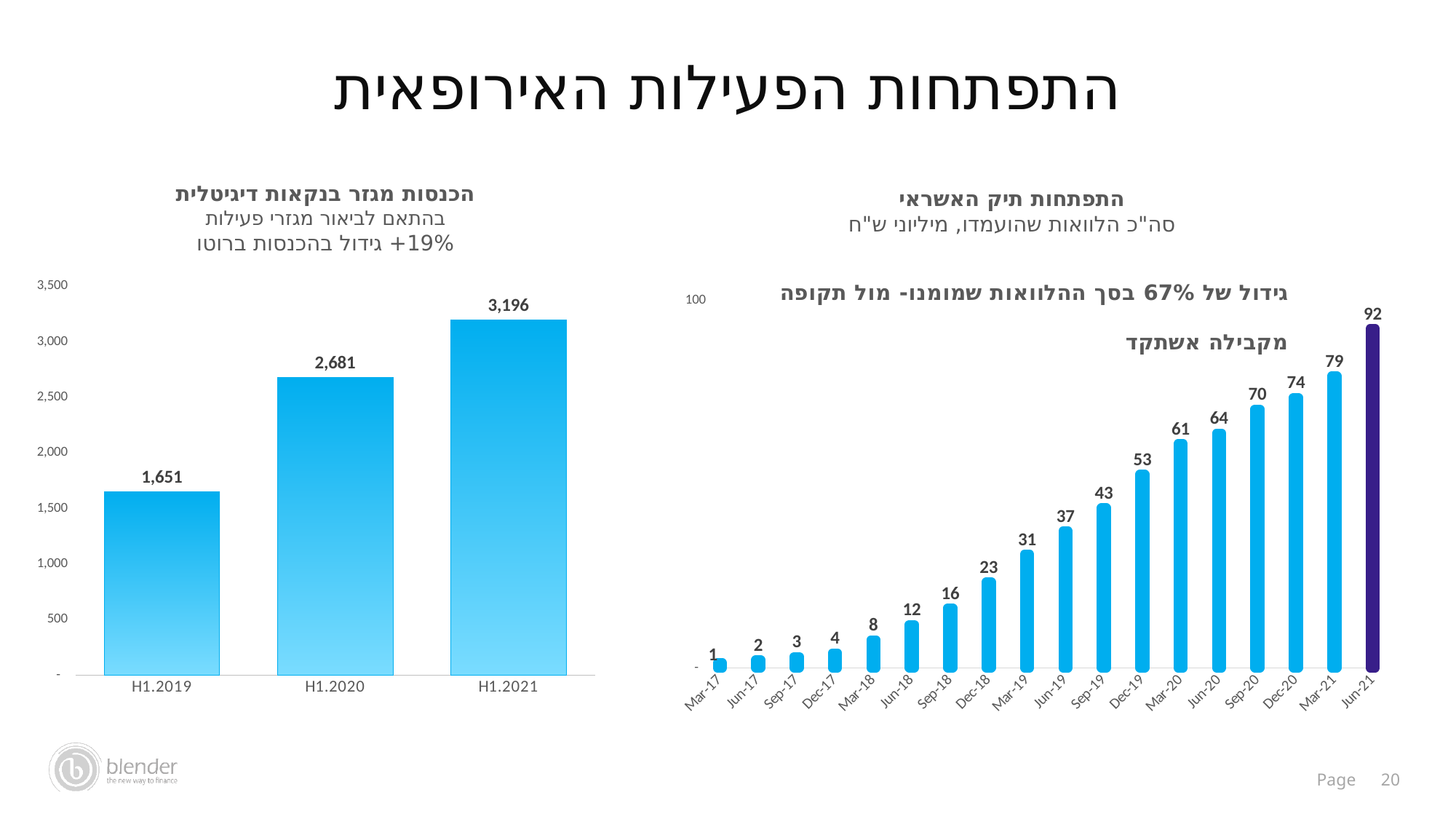
In the left chart, what is the value for H1.2019? 1,651 In the right chart, what is the difference between the Jun-21 and Mar-21 values? 13 In the right chart, what is the value for Jun-21? 92 What type of chart is the right chart? bar chart In the right chart, what is the value for Dec-19? 53 In the left chart, what is the difference between the H1.2020 and H1.2019 values? 1,030 In the left chart, do the values rise or fall from H1.2019 to H1.2021? rise In the right chart, how many periods are plotted on the x axis? 18 In the left chart, how many bars are plotted? 3 In the left chart, which period has the lowest value? H1.2019 In the left chart, what is the value for H1.2021? 3,196 In the right chart, which period has the highest value? Jun-21